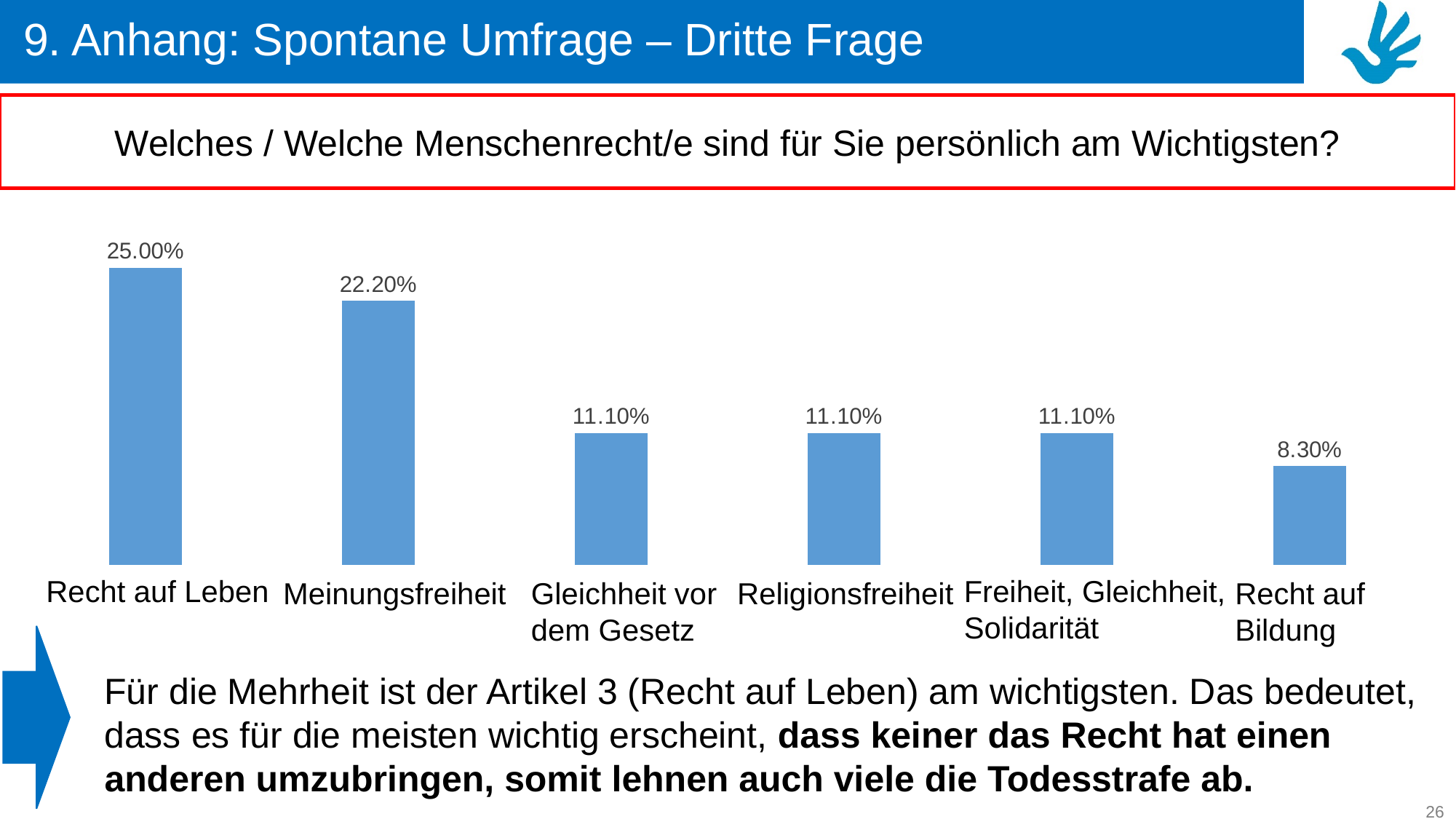
Which category has the highest value? Recht auf Leben What is the value for Meinungsfreiheit? 22.20% What is the value for Recht auf Leben? 25.00% How many categories are shown in the chart? 6 How many categories share the value 11.10%? 3 What kind of chart is shown on the slide? Bar chart What is the difference between the values for Gleichheit vor dem Gesetz and Recht auf Bildung? 2.80% What is the value for Religionsfreiheit? 11.10% Which is larger, the value for Meinungsfreiheit or the value for Religionsfreiheit? Meinungsfreiheit Which category has the lowest value? Recht auf Bildung What is the value for Recht auf Bildung? 8.30% What is the difference between the values for Recht auf Leben and Meinungsfreiheit? 2.80%